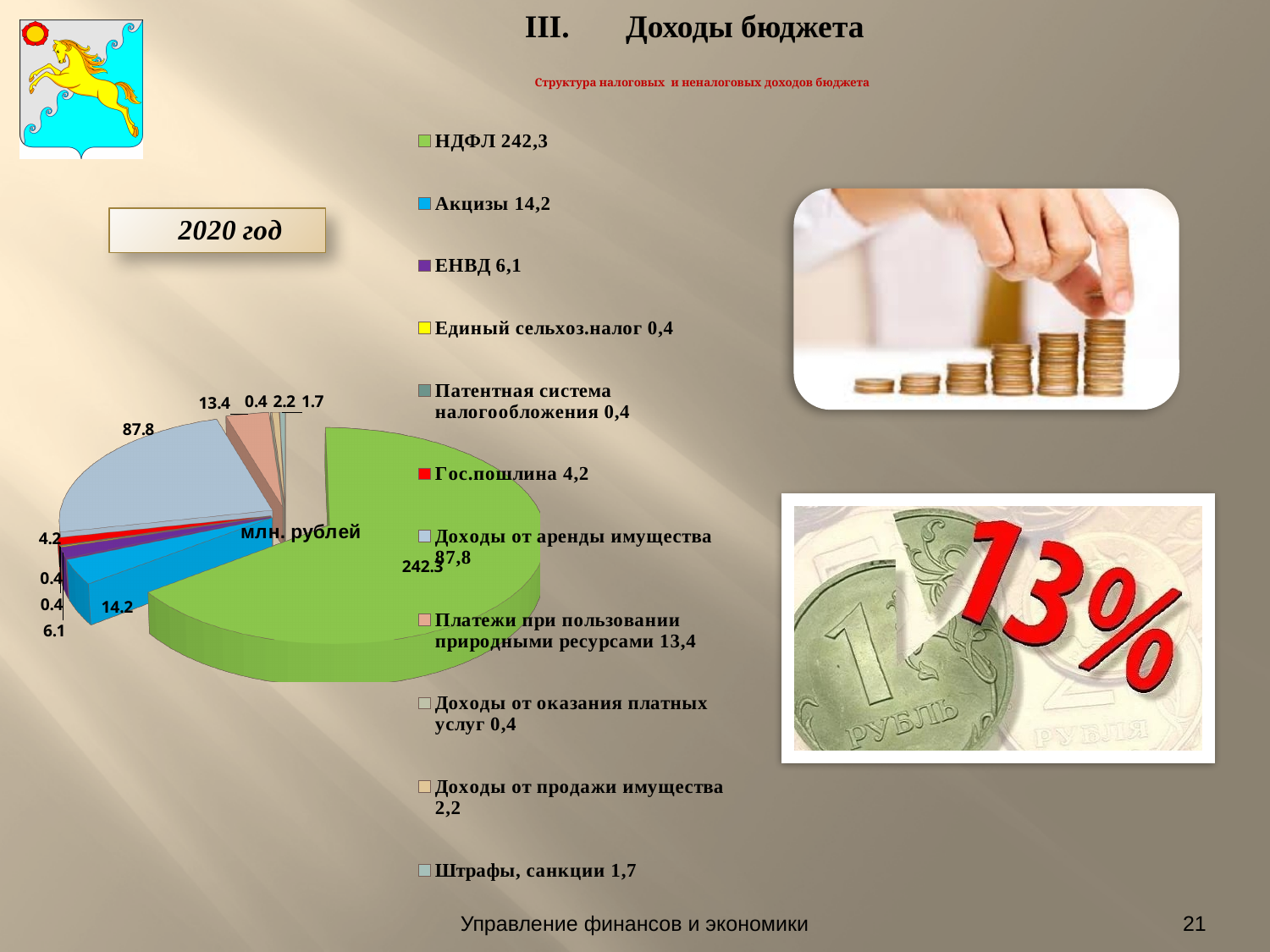
Which category has the largest slice of the pie chart? НДФЛ What is the value for Платежи при пользовании природными ресурсами? 13,4 What is the value for НДФЛ in the pie chart? 242,3 What is the title of the chart? Структура налоговых и неналоговых доходов бюджета How many categories does the pie chart legend list? 11 What unit is shown on the pie chart? млн. рублей What is the value for Акцизы in the pie chart? 14,2 What is the value for Штрафы, санкции? 1,7 What is the difference between the values for НДФЛ and Доходы от аренды имущества? 154,5 What kind of chart is shown on the slide? pie chart Which is larger: the value for ЕНВД or the value for Гос.пошлина? ЕНВД What is the value for Доходы от аренды имущества in the pie chart? 87,8